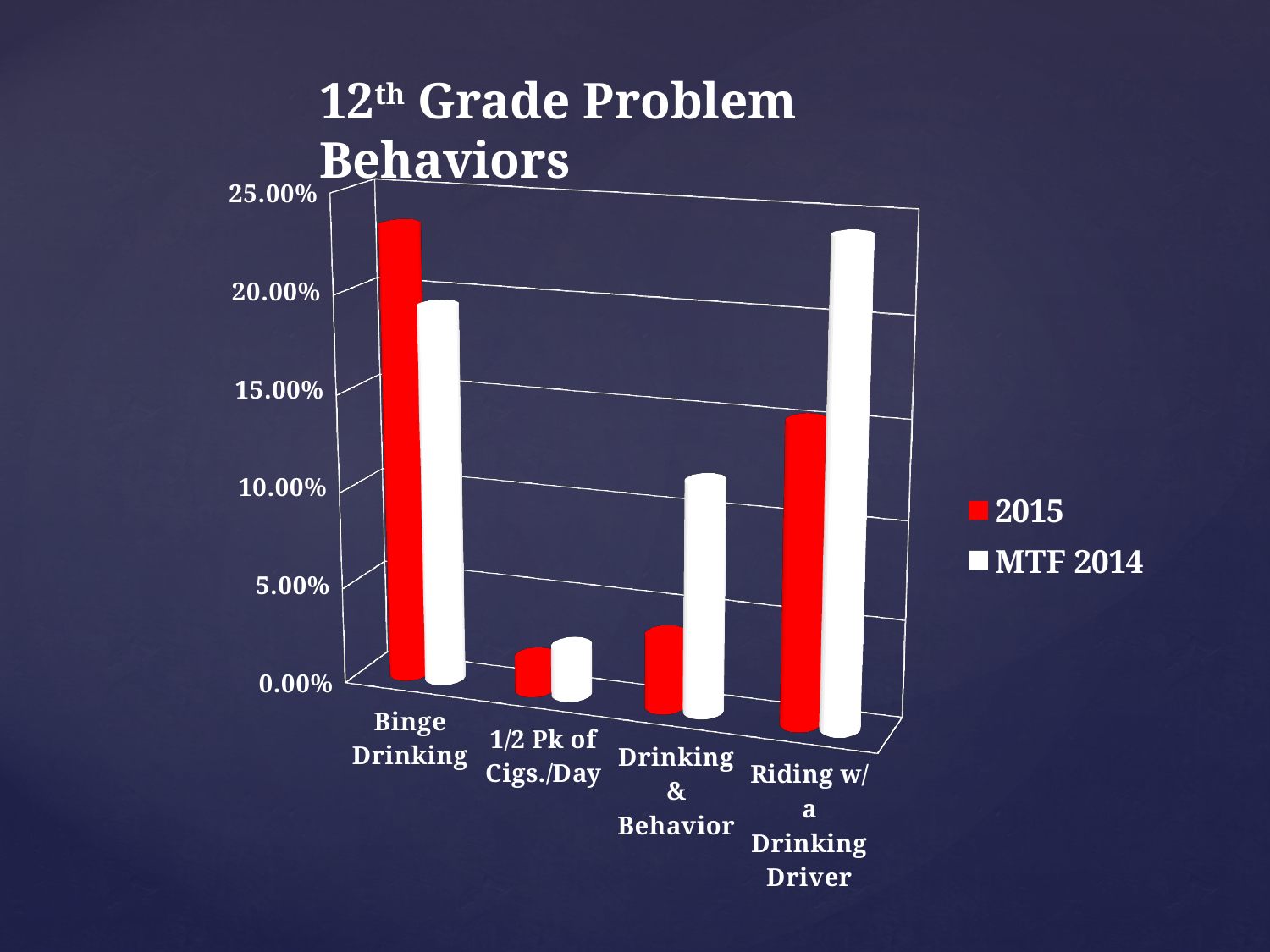
Is the 2015 value for Drinking & Behavior greater or less than 5.00%? less For Binge Drinking, which series has the larger value, 2015 or MTF 2014? 2015 What is the title of the chart? 12th Grade Problem Behaviors Which category has the highest value for the MTF 2014 series? Riding w/ a Drinking Driver Is the 2015 value for Riding w/ a Drinking Driver greater or less than 10.00%? greater For Riding w/ a Drinking Driver, which series has the larger value, 2015 or MTF 2014? MTF 2014 How many categories are shown on the x axis? 4 Which category has the lowest value for the 2015 series? 1/2 Pk of Cigs./Day Which category has the highest value for the 2015 series? Binge Drinking Is the 2015 value for Binge Drinking greater or less than 20.00%? greater What kind of chart is shown on the slide? Bar chart How many series does the legend list? 2